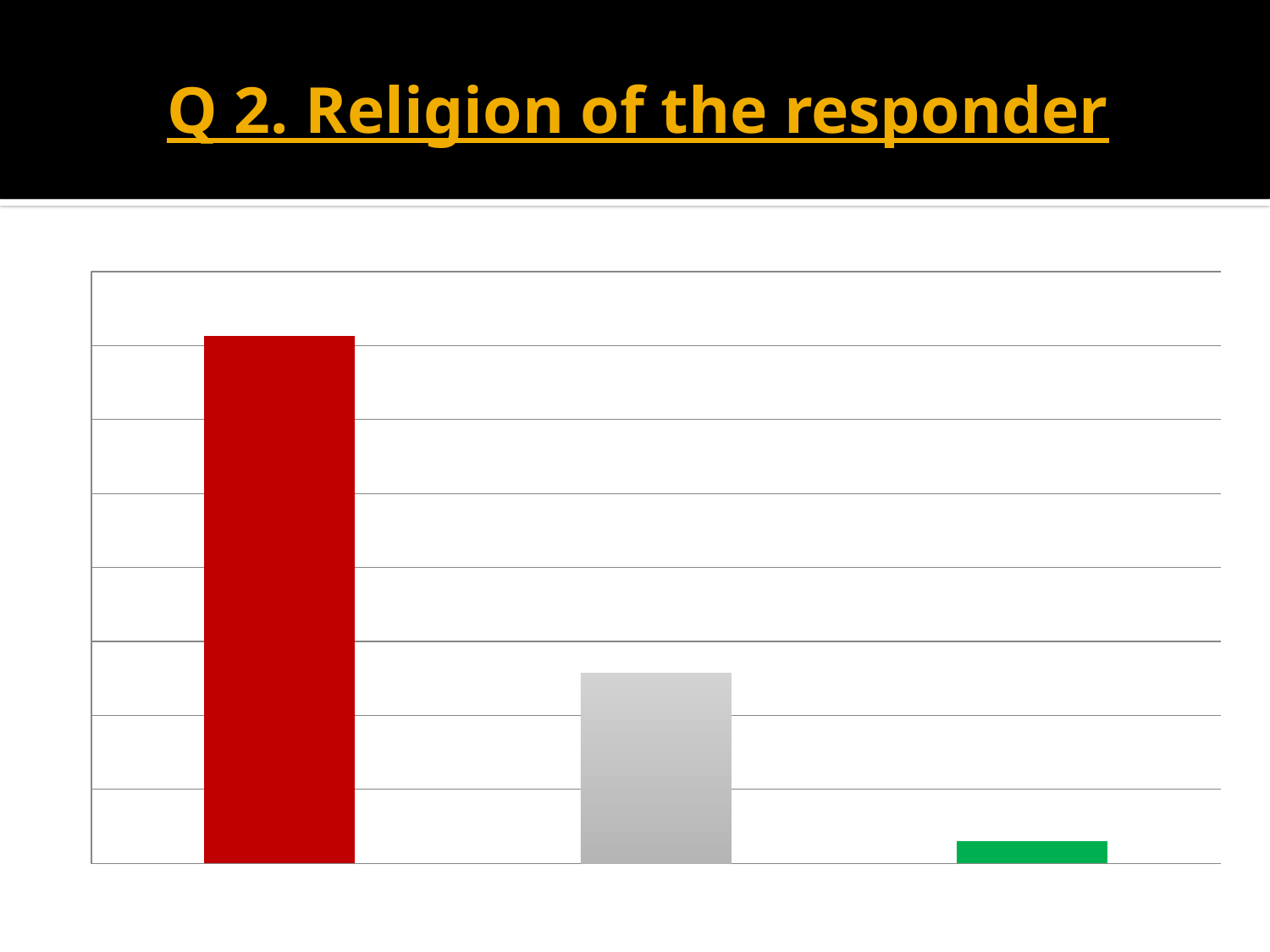
What is the title of the slide containing the chart? Q 2. Religion of the responder Which is larger, the red bar or the grey bar? red bar Which bar is the tallest in the chart: the red, grey or green one? red Which is larger, the grey bar or the green bar? grey bar What colour is the leftmost bar in the chart? red What kind of chart is shown on the slide? bar chart Do the bar values rise or fall from left to right across the chart? fall How many bars are plotted in the chart? 3 Which bar is the shortest in the chart: the red, grey or green one? green